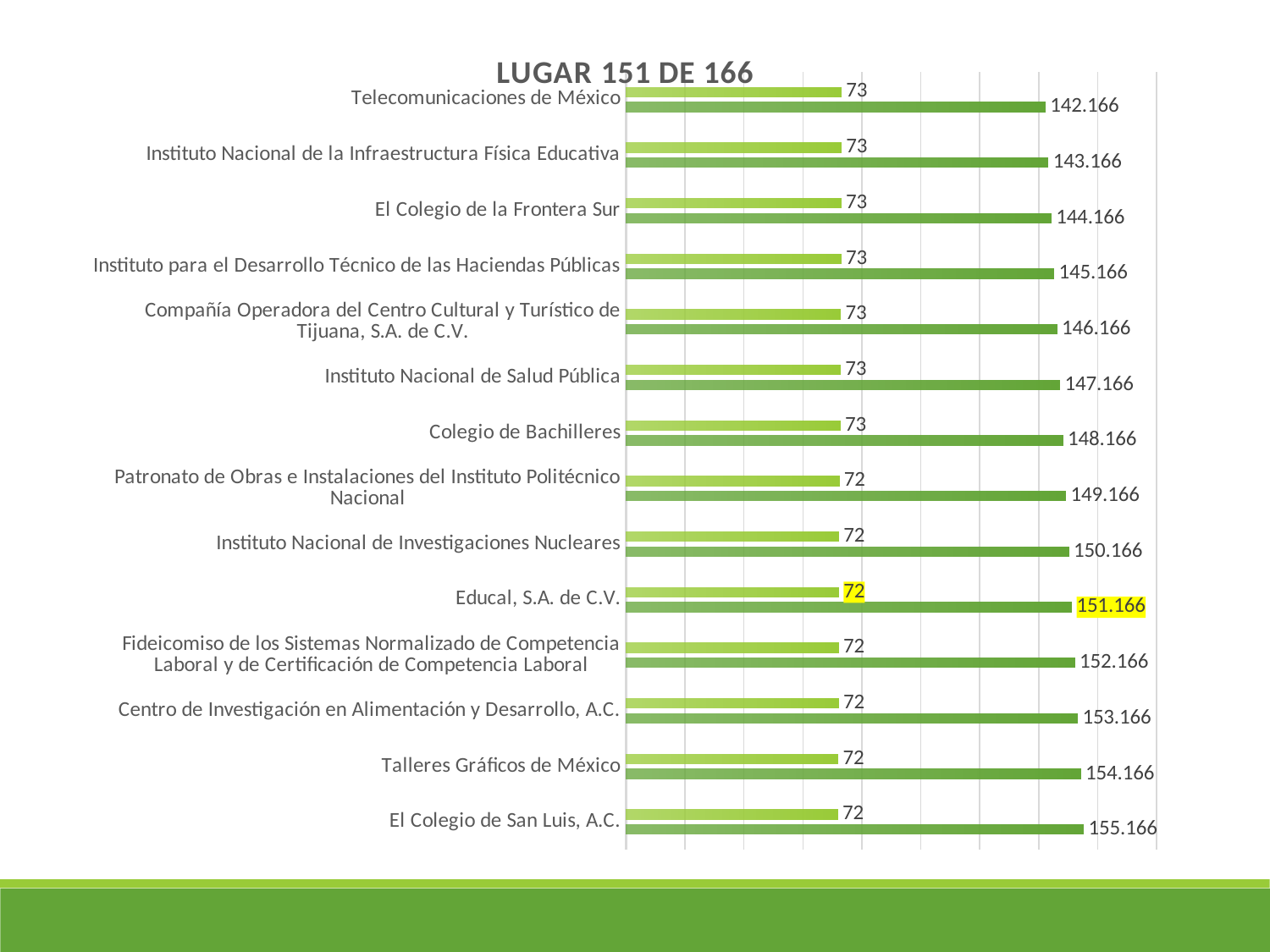
Which is larger, the dark green bar value for Talleres Gráficos de México or for Instituto Nacional de Salud Pública? Talleres Gráficos de México What kind of chart is shown on the slide? bar chart What is the value of the dark green bar for Telecomunicaciones de México? 142.166 What is the title of the chart? LUGAR 151 DE 166 What is the value of the light green bar for Colegio de Bachilleres? 73 What is the value of the light green bar for Educal, S.A. de C.V.? 72 Which institution has the lowest dark green bar value? Telecomunicaciones de México What is the value of the dark green bar for El Colegio de San Luis, A.C.? 155.166 Which institution's data labels are highlighted in yellow? Educal, S.A. de C.V. How many categories (institutions) are listed on the chart? 14 What is the value of the dark green bar for Educal, S.A. de C.V.? 151.166 Which institution has the highest dark green bar value? El Colegio de San Luis, A.C.